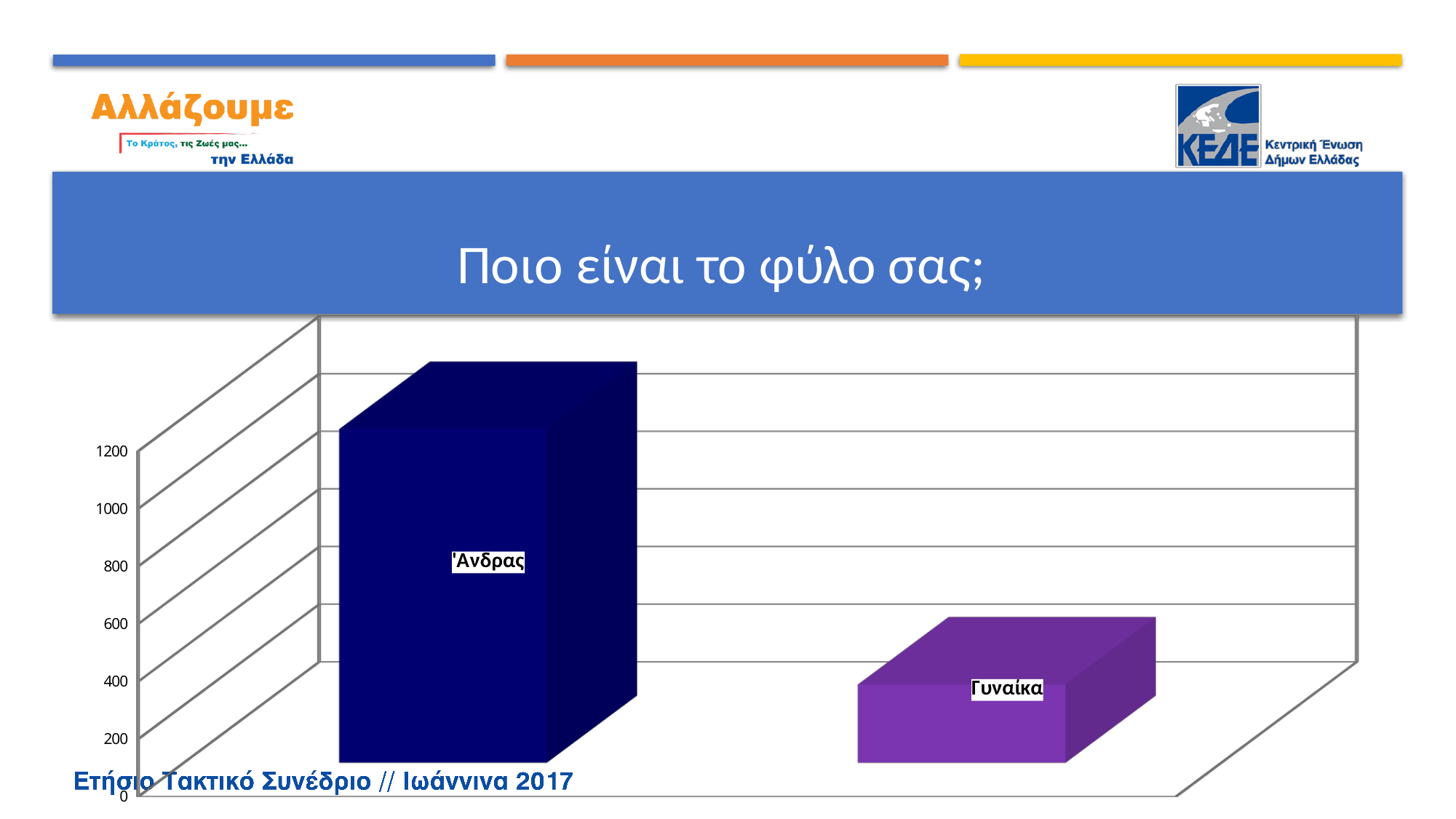
Which is larger, the value for Άνδρας or the value for Γυναίκα? Άνδρας Is the value for Γυναίκα greater or less than 600? less Which category has the highest value in the chart? Άνδρας What is the title of the chart on the slide? Ποιο είναι το φύλο σας; Is the value for Άνδρας greater or less than 800? greater What is the highest value shown on the vertical axis of the chart? 1200 What kind of chart is shown on the slide? Bar chart Is the value for Γυναίκα greater or less than 200? greater Which category has the lowest value in the chart? Γυναίκα What colour is the bar for Γυναίκα? Purple How many categories are plotted in the chart? 2